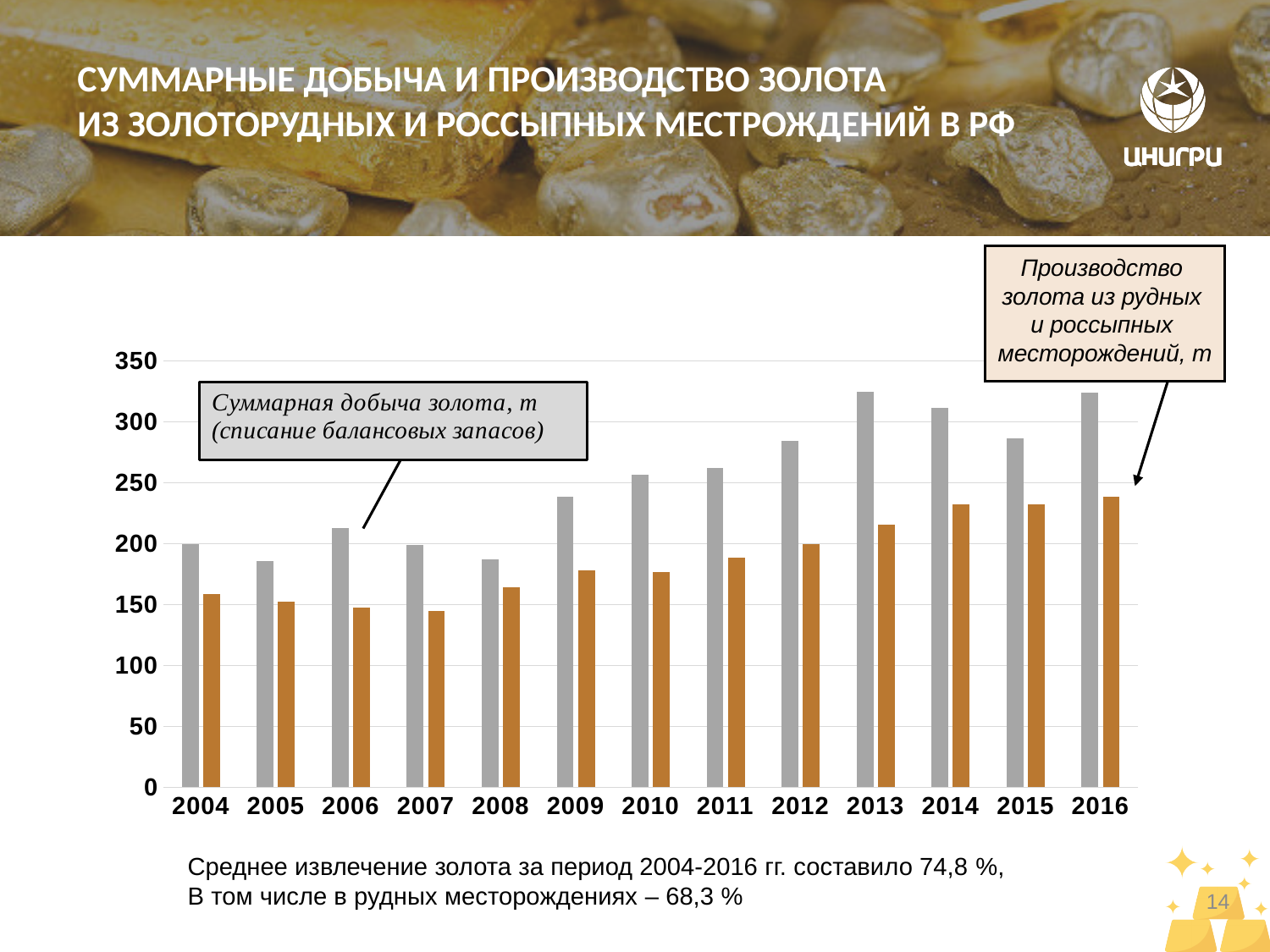
What kind of chart is shown on the slide? bar chart How many years are shown on the x axis of the chart? 13 Which is larger: Суммарная добыча золота in 2013 or in 2004? 2013 Is the value of Производство золота (orange bar) for 2007 greater or less than 150? less How many data series are plotted in the chart? 2 Does Производство золота (orange bars) generally rise or fall from 2008 to 2016? rise Is the value of Производство золота (orange bar) for 2016 greater or less than 250? less What colour are the bars for Производство золота из рудных и россыпных месторождений? orange Is the value of Суммарная добыча золота (gray bar) for 2013 greater or less than 300? greater In 2010, which series has the larger value: Суммарная добыча золота or Производство золота? Суммарная добыча золота